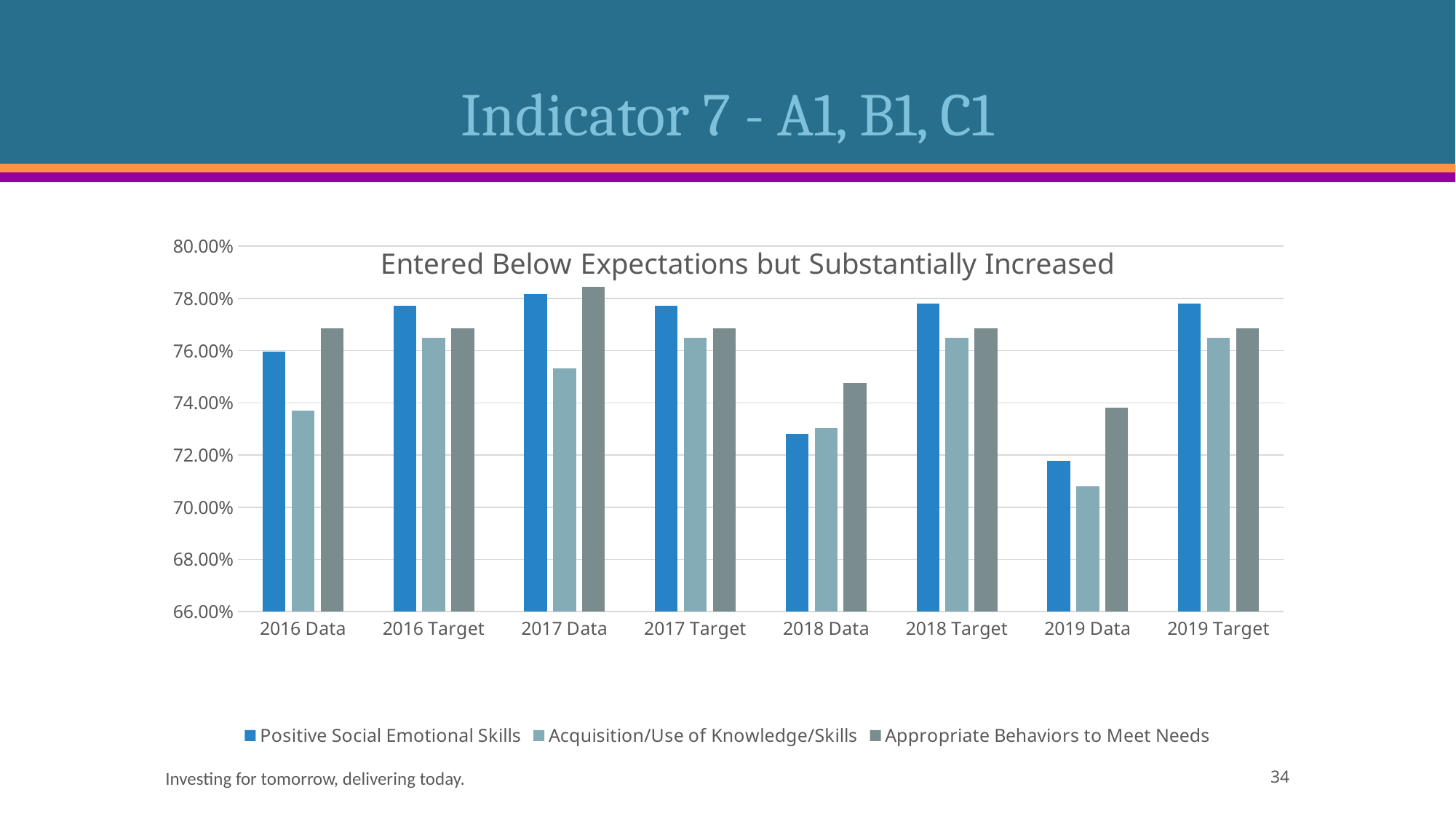
In 2019 Data, which is larger: Positive Social Emotional Skills or Appropriate Behaviors to Meet Needs? Appropriate Behaviors to Meet Needs In 2016 Data, which is larger: Positive Social Emotional Skills or Acquisition/Use of Knowledge/Skills? Positive Social Emotional Skills Is the value for Acquisition/Use of Knowledge/Skills in 2016 Data greater or less than 74.00%? less How many series does the legend list? 3 How many categories are shown along the x axis? 8 Is the value for Acquisition/Use of Knowledge/Skills in 2019 Data greater or less than 72.00%? less In which category is the Appropriate Behaviors to Meet Needs bar highest? 2017 Data Is the value for Appropriate Behaviors to Meet Needs in 2018 Data greater or less than 74.00%? greater What kind of chart is shown on the slide? bar chart In which category is the Acquisition/Use of Knowledge/Skills bar lowest? 2019 Data What is the title of the chart? Entered Below Expectations but Substantially Increased